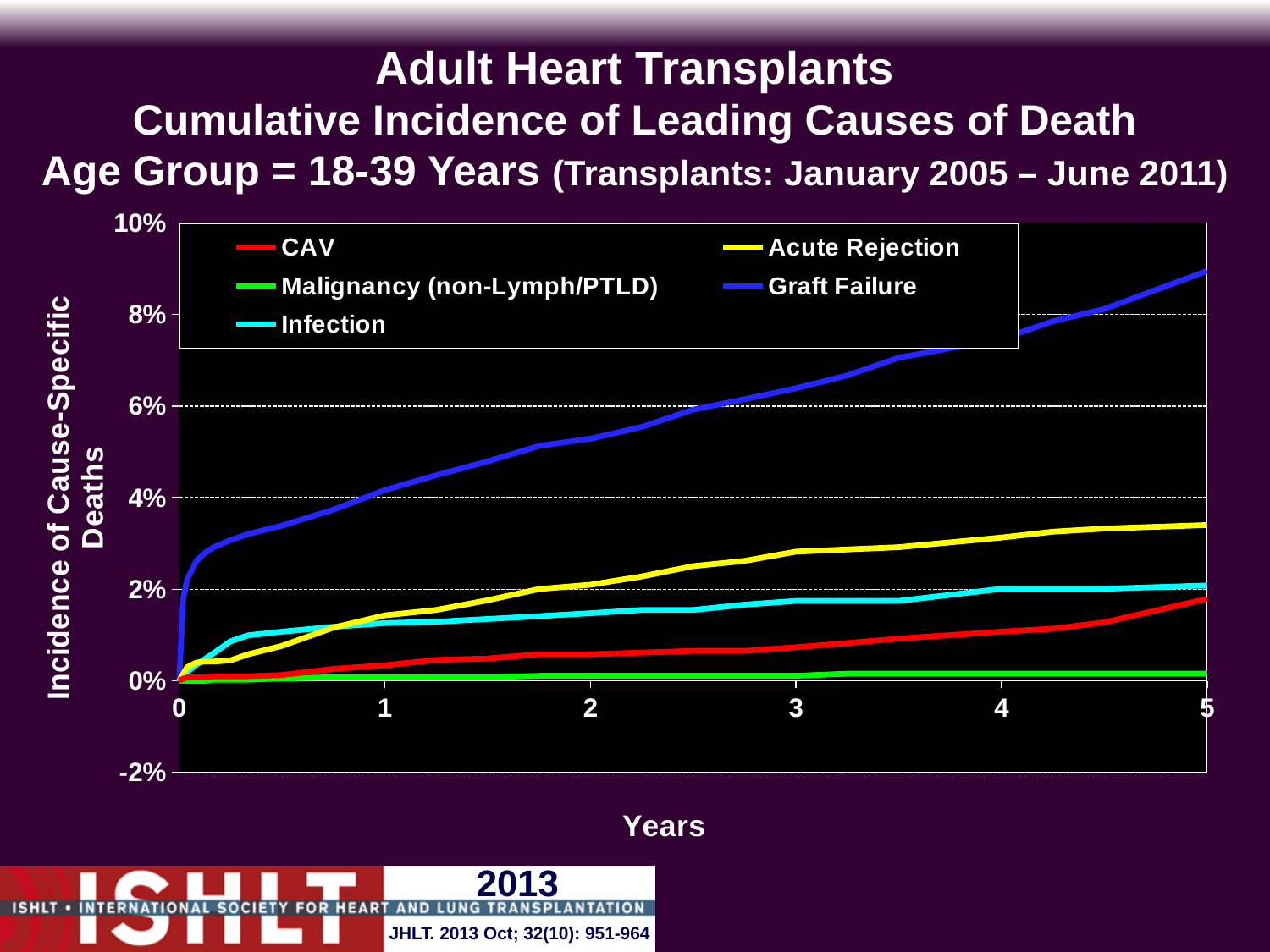
Is the value for CAV at 3 years greater or less than 2%? less Is the value for Acute Rejection at 5 years greater or less than 4%? less What kind of chart is shown on the slide? line chart Does the Graft Failure line rise or fall as years increase from 0 to 5? rise Which cause of death has the highest cumulative incidence at 5 years? Graft Failure Which cause of death has the lowest cumulative incidence at 5 years? Malignancy (non-Lymph/PTLD) Which age group does the chart cover, according to the title? 18-39 Years Is the value for Graft Failure at 5 years greater or less than 8%? greater How many series does the legend list? 5 At 5 years, which is larger: the value for Acute Rejection or the value for Infection? Acute Rejection What colour is the line for Acute Rejection in the legend? yellow